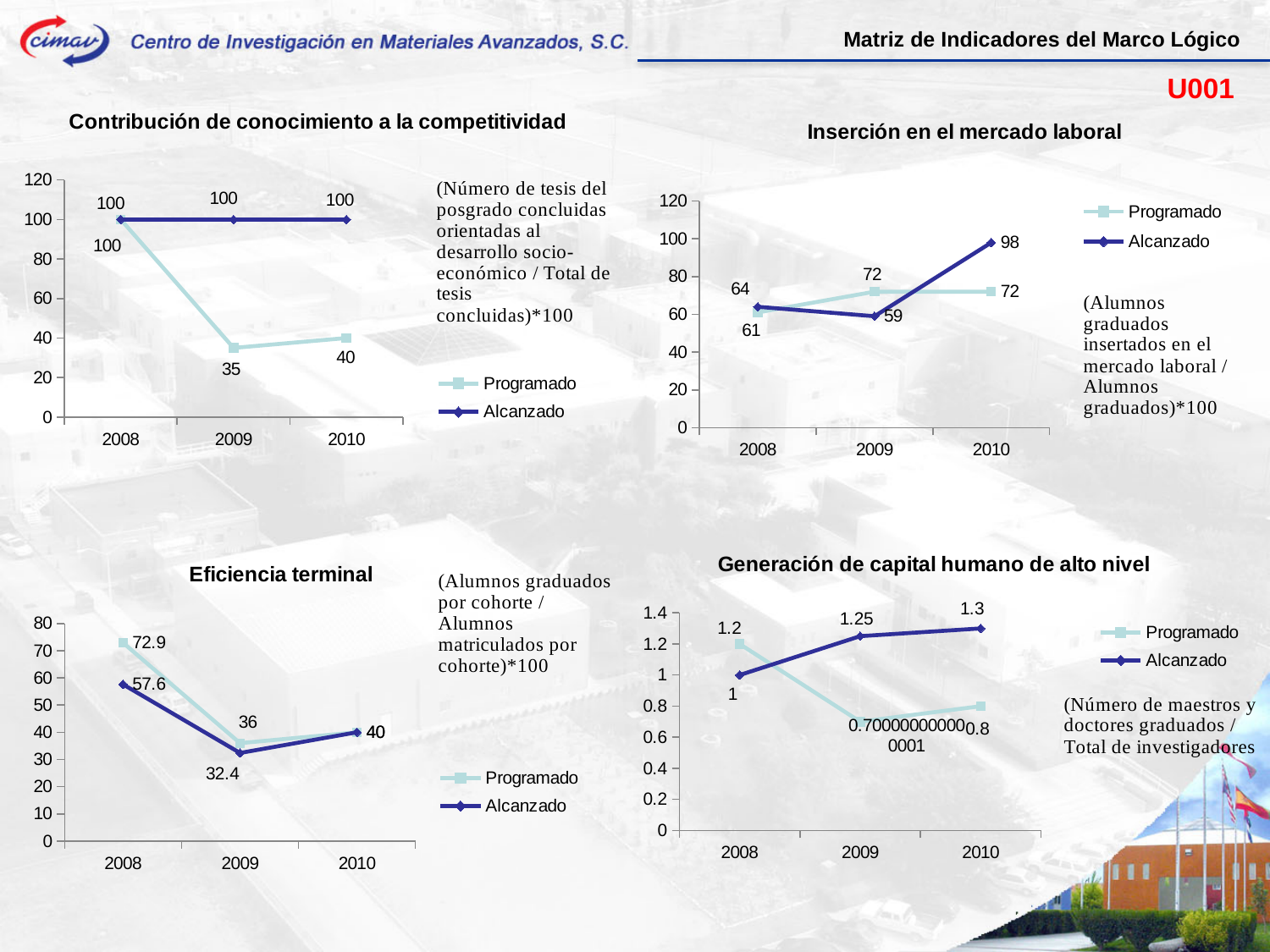
In the chart titled 'Contribución de conocimiento a la competitividad', what is the Programado value for 2009? 35 In the chart titled 'Eficiencia terminal', what is the Alcanzado value for 2009? 32.4 In the chart titled 'Contribución de conocimiento a la competitividad', what is the difference between the Alcanzado and Programado values in 2009? 65 In the chart titled 'Inserción en el mercado laboral', which year has the lowest Alcanzado value? 2009 In the chart titled 'Eficiencia terminal', which is larger in 2008, Programado or Alcanzado? Programado In the chart titled 'Generación de capital humano de alto nivel', does the Alcanzado series rise or fall from 2008 to 2010? rise In the chart titled 'Generación de capital humano de alto nivel', what is the Alcanzado value for 2009? 1.25 In the chart titled 'Inserción en el mercado laboral', what is the Programado value for 2008? 61 In the chart titled 'Inserción en el mercado laboral', what is the Alcanzado value for 2010? 98 In the chart titled 'Contribución de conocimiento a la competitividad', what is the Alcanzado value for 2010? 100 How many series does the legend list in the chart titled 'Inserción en el mercado laboral'? 2 In the chart titled 'Eficiencia terminal', what is the difference between the Programado and Alcanzado values in 2008? 15.3